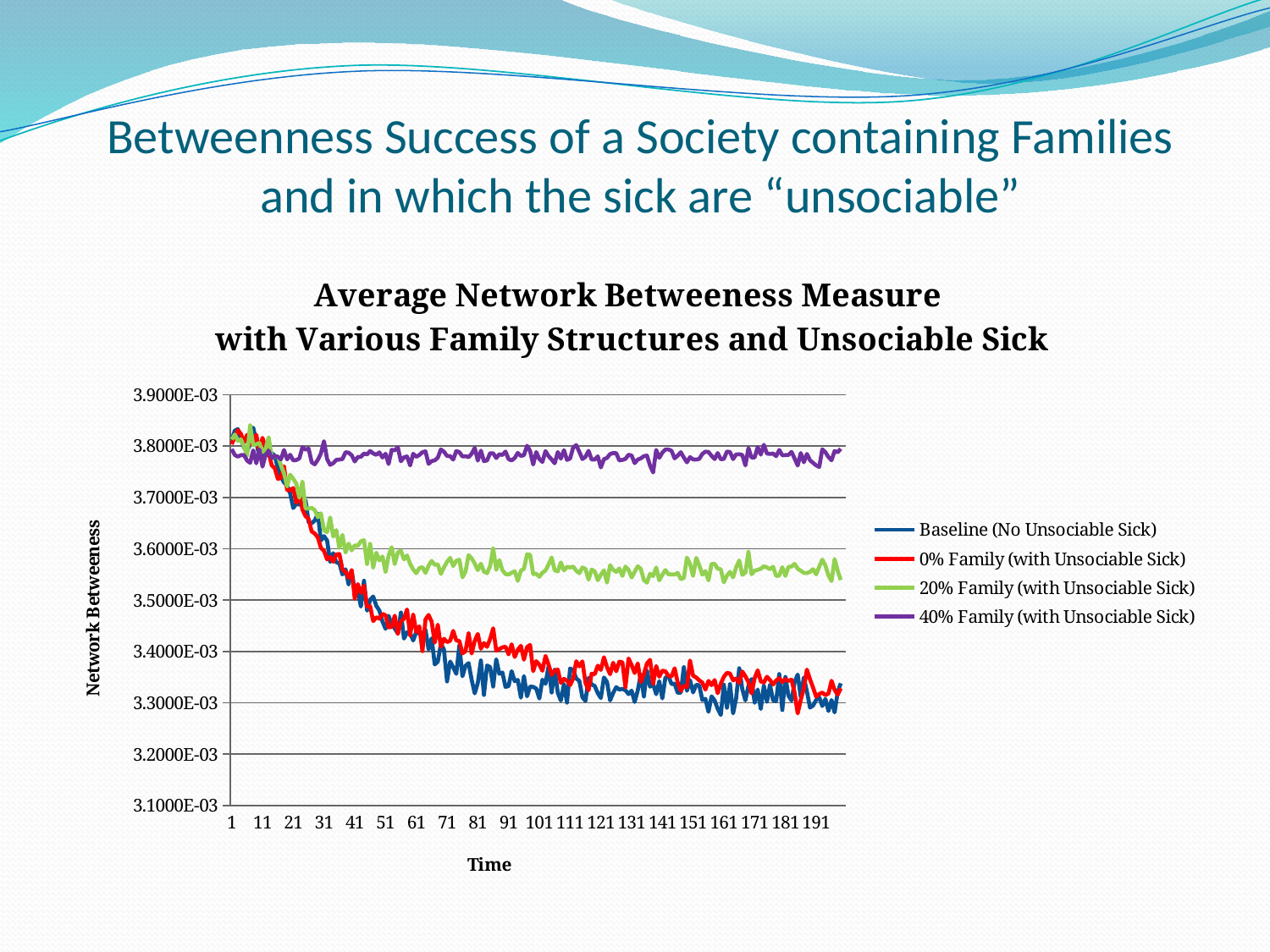
What is the title of the chart? Average Network Betweeness Measure with Various Family Structures and Unsociable Sick At time 121, which is larger: the 40% Family (with Unsociable Sick) series or the Baseline (No Unsociable Sick) series? 40% Family (with Unsociable Sick) What kind of chart is shown on the slide? line chart How many series does the legend list? 4 What is the label of the vertical axis? Network Betweeness Is the value of the 40% Family (with Unsociable Sick) series at time 101 greater or less than 3.7000E-03? greater Is the value of the Baseline (No Unsociable Sick) series at time 181 greater or less than 3.4000E-03? less Does the Baseline (No Unsociable Sick) series rise or fall over time? fall Does the 40% Family (with Unsociable Sick) series rise, fall, or stay roughly flat over time? stay roughly flat Which series has the highest values at the end of the time period? 40% Family (with Unsociable Sick) At time 191, which is larger: the 20% Family (with Unsociable Sick) series or the 0% Family (with Unsociable Sick) series? 20% Family (with Unsociable Sick)